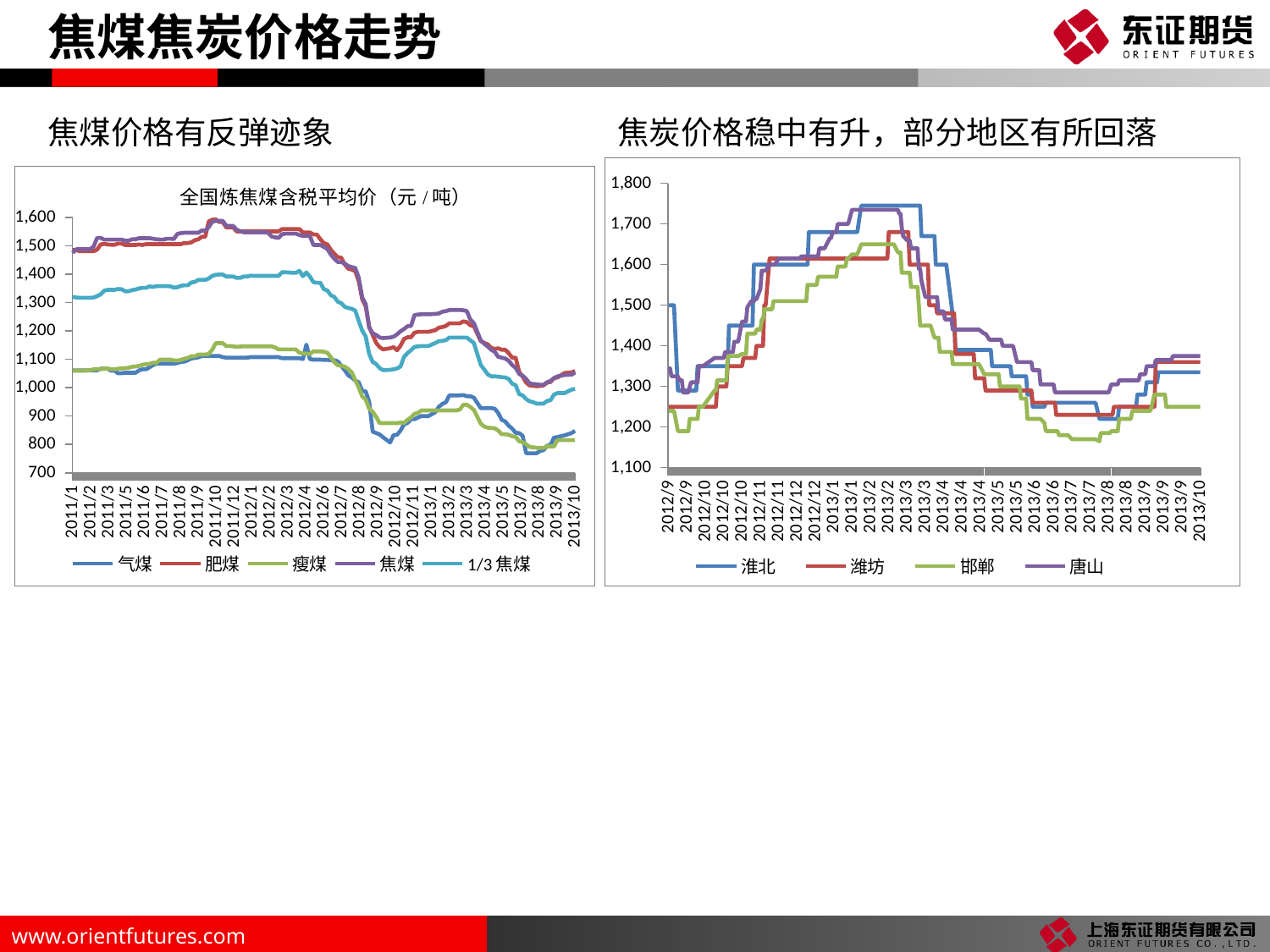
In the right chart (焦炭价格), is the value for 淮北 around 2013/2 greater or less than 1,700? greater In the left chart (全国炼焦煤含税平均价), is the value for 瘦煤 around 2013/8 greater or less than 800? less What kind of chart is the left chart titled 全国炼焦煤含税平均价（元/吨）? line chart In the right chart (焦炭价格), does the 淮北 series rise or fall between 2013/2 and 2013/7? fall In the left chart (全国炼焦煤含税平均价), is the value for 1/3焦煤 at 2011/1 greater or less than 1,300? greater How many series does the legend of the left chart (全国炼焦煤含税平均价) list? 5 In the left chart (全国炼焦煤含税平均价), does the 焦煤 series rise or fall between 2011/10 and 2013/8? fall How many series does the legend of the right chart (焦炭价格) list? 4 What is the title printed inside the left chart? 全国炼焦煤含税平均价（元/吨）